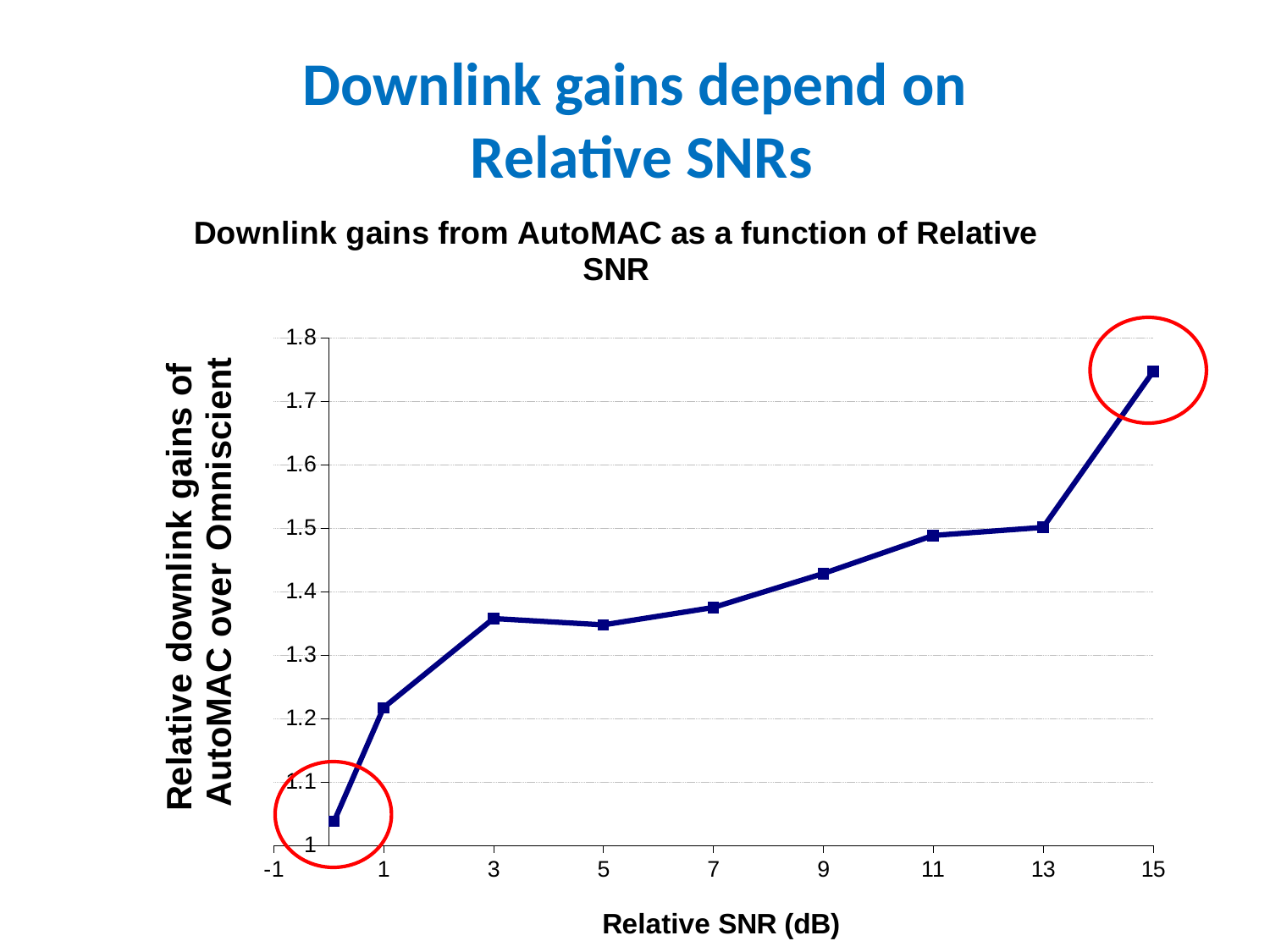
Is the relative downlink gain at a Relative SNR of 7 dB greater or less than 1.3? greater What is the title of the chart? Downlink gains from AutoMAC as a function of Relative SNR Do the relative downlink gains generally rise or fall as Relative SNR increases? rise What is the label of the x axis? Relative SNR (dB) Is the relative downlink gain at a Relative SNR of 15 dB greater or less than 1.7? greater How many data points are plotted on the line? 9 What kind of chart is shown on the slide? line chart Is the relative downlink gain at a Relative SNR of 1 dB greater or less than 1.3? less Which has the larger relative downlink gain: a Relative SNR of 9 dB or 5 dB? 9 dB At which Relative SNR value is the relative downlink gain highest? 15